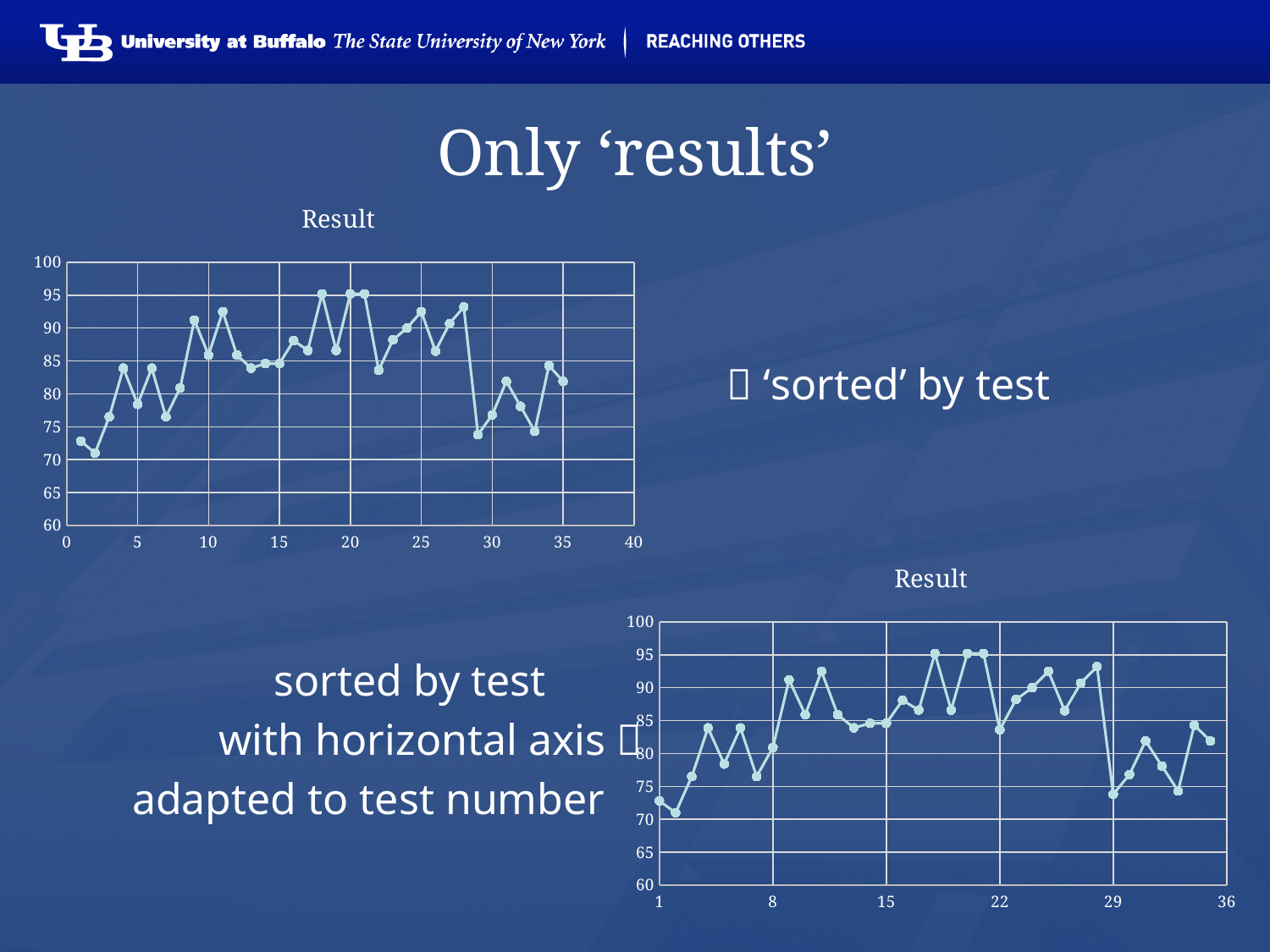
What is the highest value shown on the horizontal axis of the top-left chart? 40 In the top-left chart, do the values generally rise or fall between x = 1 and x = 9? rise In the bottom-right chart, is the value at test 29 greater or less than 80? less In the top-left chart, is the value at x = 2 greater or less than 75? less In the bottom-right chart, is the value at test 1 greater or less than 75? less How many charts are shown on the slide? 2 In the top-left chart, is the value at x = 20 larger or smaller than the value at x = 22? larger What kind of chart is the top-left chart on the slide? line chart What is the title of the top-left chart? Result What kind of chart is the bottom-right chart on the slide? line chart